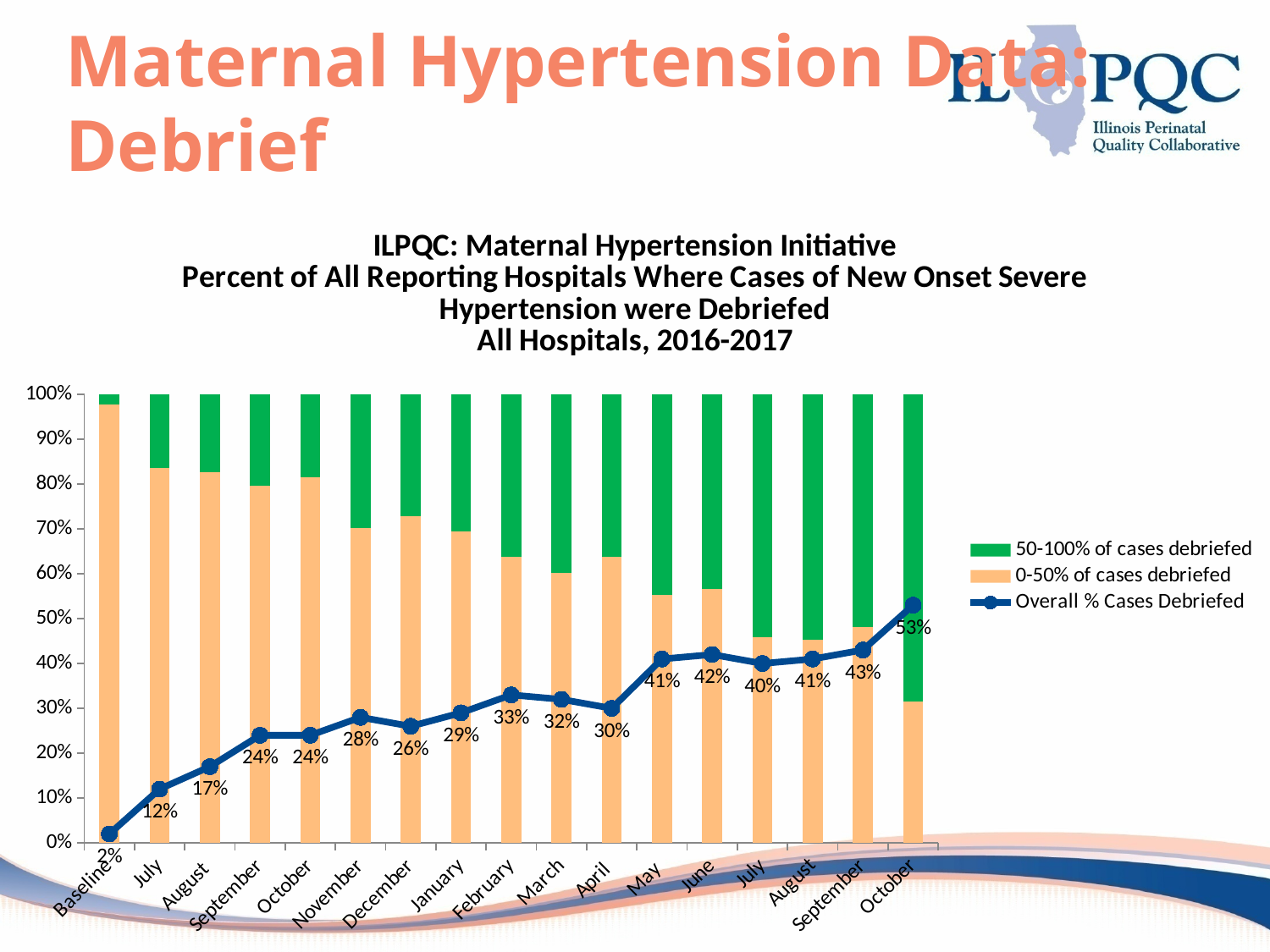
Which category has the highest Overall % Cases Debriefed value? October (the last category), 53% By how much does the Overall % Cases Debriefed value for May exceed the value for April? 11 percentage points What kind of chart is shown on the slide? A stacked bar chart with a line overlay What is the Overall % Cases Debriefed value for May? 41% Does the Overall % Cases Debriefed line generally rise or fall from Baseline to the final October? rise How many series does the legend list? 3 Is the 0-50% of cases debriefed value for November greater or less than 60%? greater What is the Overall % Cases Debriefed value for February? 33% How many categories are shown along the x axis? 17 Which has the larger Overall % Cases Debriefed value, February or March? February What is the Overall % Cases Debriefed value at Baseline? 2% Which category has the lowest Overall % Cases Debriefed value? Baseline